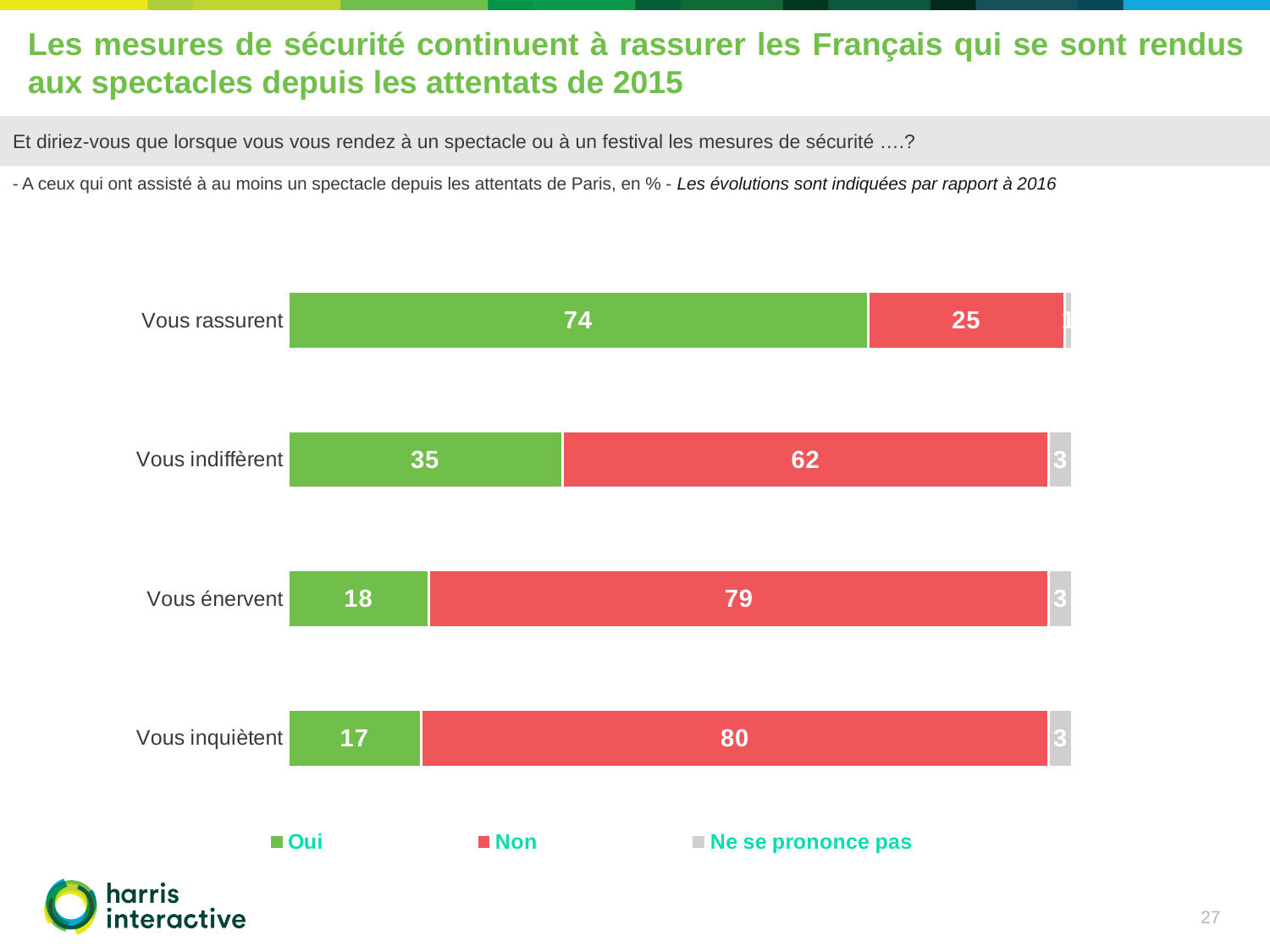
Which colour represents the "Non" series in the chart? Red What is the "Ne se prononce pas" value for "Vous énervent"? 3 What is the difference between the "Non" values for "Vous inquiètent" and "Vous indiffèrent"? 18 What kind of chart is shown on the slide? Stacked bar chart What percentage of respondents answered "Oui" for "Vous rassurent"? 74 What is the "Oui" value for "Vous indiffèrent"? 35 Which category has the lowest "Non" value? Vous rassurent How many categories are shown in the chart? 4 Which category has the highest "Oui" value? Vous rassurent Which is larger: the "Oui" value for "Vous énervent" or the "Oui" value for "Vous inquiètent"? Vous énervent How many series does the legend list? 3 What is the "Non" value for "Vous inquiètent"? 80